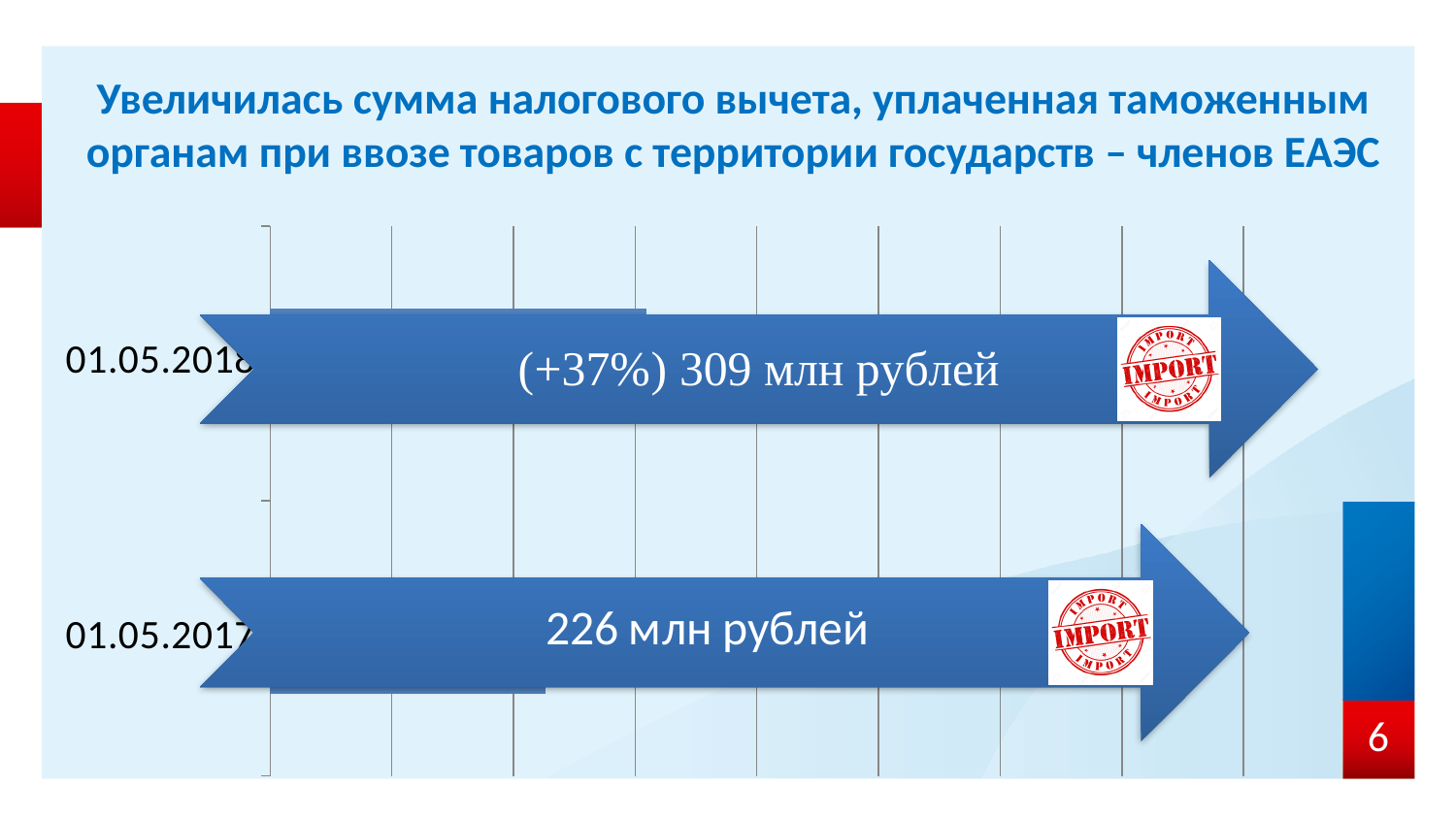
How many categories (dates) are shown in the chart? 2 What is the value shown for 01.05.2017? 226 млн рублей Is the value for 01.05.2018 larger or smaller than the value for 01.05.2017? larger What is the value shown for 01.05.2018? 309 млн рублей What kind of chart is shown on the slide? bar chart Did the value increase or decrease from 01.05.2017 to 01.05.2018? increase Which date has the higher value? 01.05.2018 What image is placed at the end of each bar? an IMPORT stamp What colour are the bars in the chart? blue What percentage change is printed on the bar for 01.05.2018? +37% By how much does the value for 01.05.2018 exceed the value for 01.05.2017? 83 млн рублей Which date has the lower value? 01.05.2017